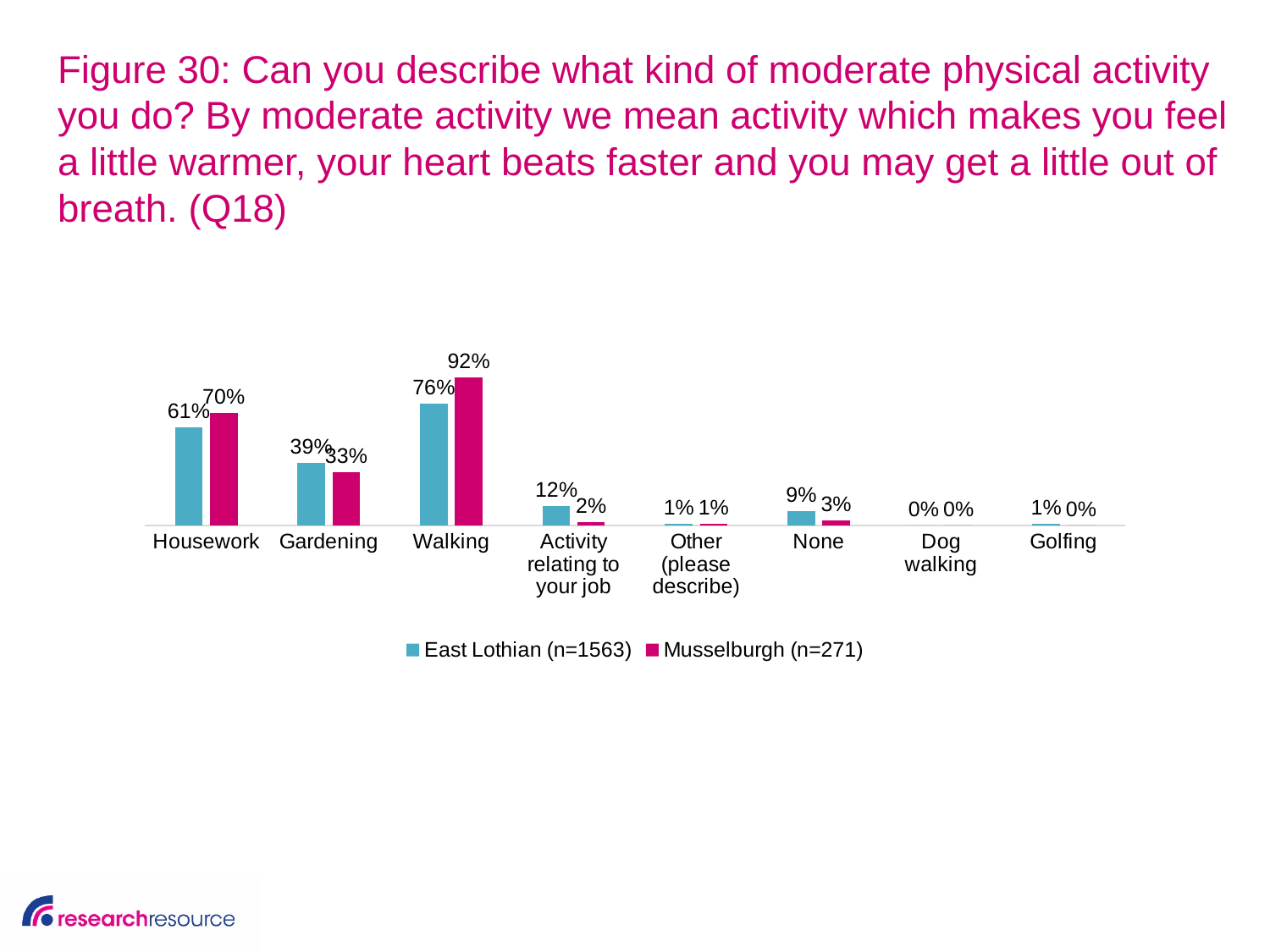
How many activity categories are shown on the x axis? 8 Which activity has the highest value for East Lothian? Walking What percentage of Musselburgh respondents said Housework? 70% What is the value for Musselburgh for Activity relating to your job? 2% For None, which group has the larger value, East Lothian or Musselburgh? East Lothian What kind of chart is shown on the slide? Bar chart For Housework, which group has the larger value, East Lothian or Musselburgh? Musselburgh Which activity has the highest value for Musselburgh? Walking How many series does the legend list? 2 What is the difference between the East Lothian and Musselburgh values for Gardening? 6 percentage points What is the difference between the Musselburgh and East Lothian values for Walking? 16 percentage points What percentage of East Lothian respondents said Walking? 76%